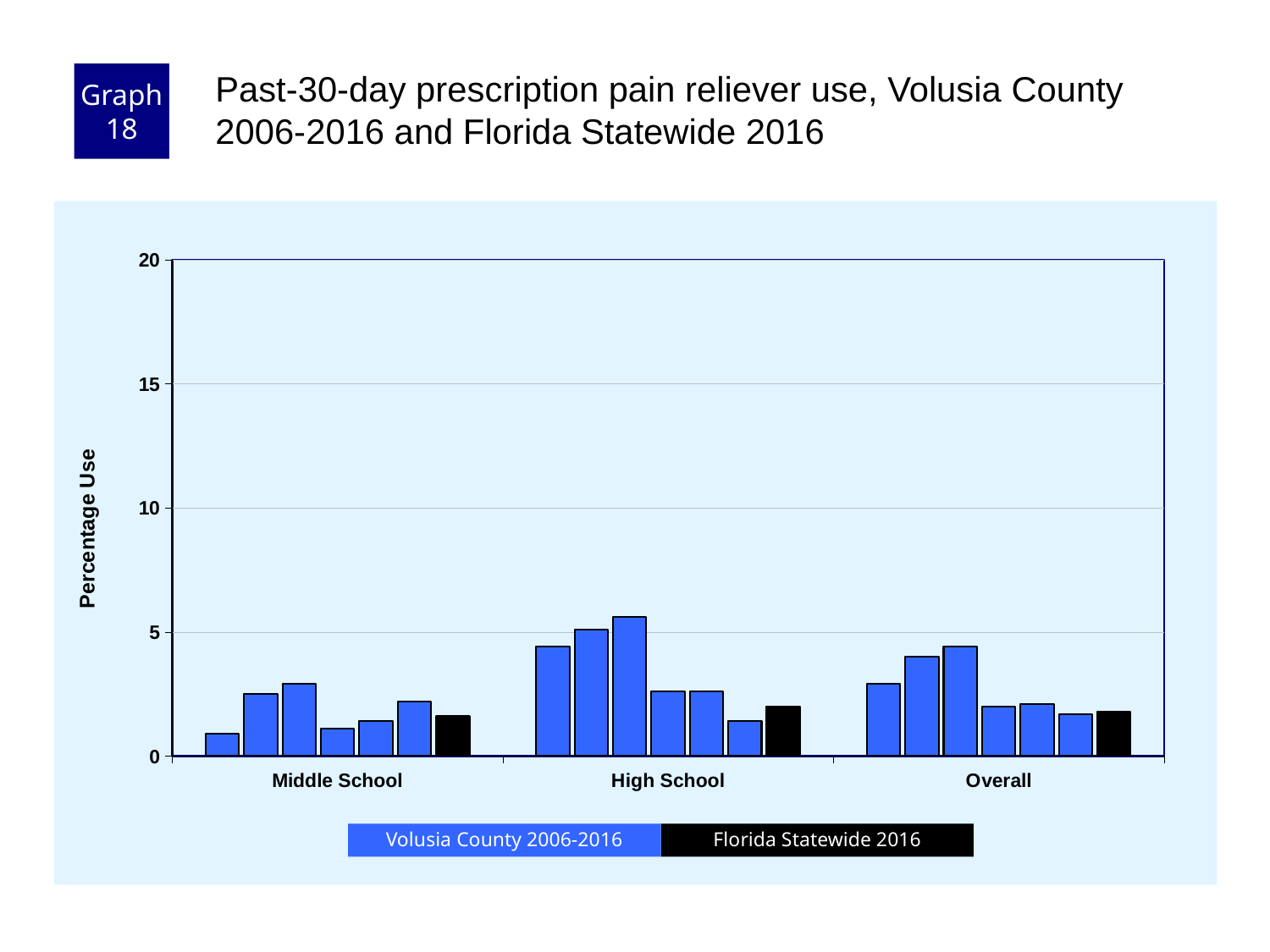
Is the Florida Statewide 2016 value for Middle School greater or less than 5? less How many series does the legend list? 2 Which is larger: the tallest Volusia County 2006-2016 bar for High School or the tallest Volusia County 2006-2016 bar for Middle School? High School Is the Florida Statewide 2016 value for Overall greater or less than 5? less Which colour represents Florida Statewide 2016 in the legend? black What is the label on the y axis? Percentage Use How many categories are shown on the x axis? 3 Is the tallest bar in the Overall category greater or less than 5? less Which category contains the tallest bar in the chart? High School What kind of chart is shown on the slide? bar chart